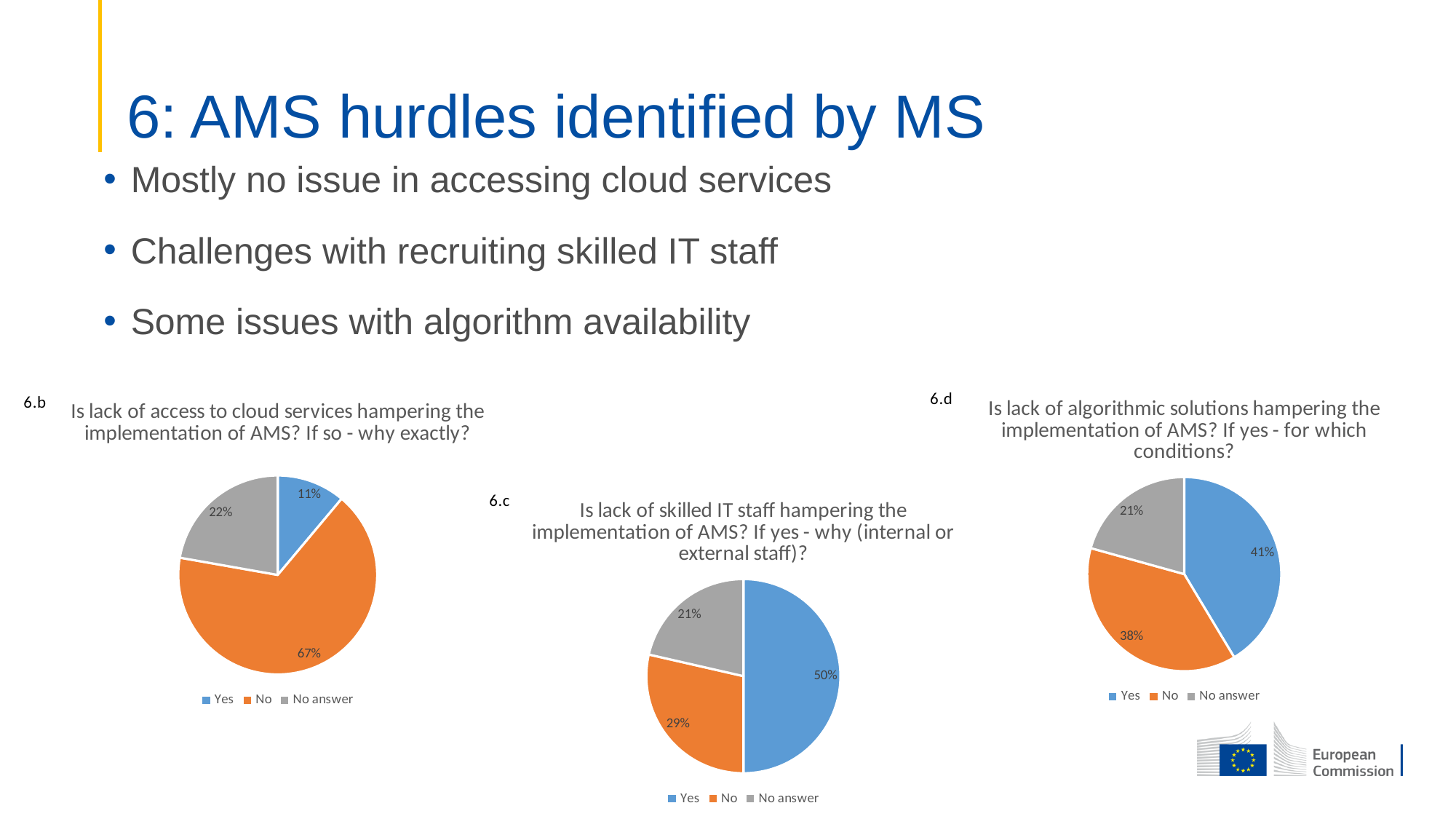
How many charts are shown on the slide? 3 In the right pie chart (6.d, lack of algorithmic solutions), what share of respondents gave No answer? 21% In the right pie chart (6.d, lack of algorithmic solutions), what share of respondents answered Yes? 41% In the middle pie chart (6.c, lack of skilled IT staff), what share of respondents answered No? 29% In the left pie chart (6.b, lack of access to cloud services), which response has the largest share? No In the left pie chart (6.b, lack of access to cloud services), what share of respondents answered Yes? 11% In the left pie chart (6.b, lack of access to cloud services), what is the difference in percentage points between the No and Yes shares? 56 In the middle pie chart (6.c, lack of skilled IT staff), what share of respondents answered Yes? 50% What type of chart is used for chart 6.c (lack of skilled IT staff)? Pie chart In the right pie chart (6.d, lack of algorithmic solutions), which is larger, the Yes share or the No share? Yes In the middle pie chart (6.c, lack of skilled IT staff), which response has the smallest share? No answer In the left pie chart (6.b, lack of access to cloud services), what share of respondents answered No? 67%